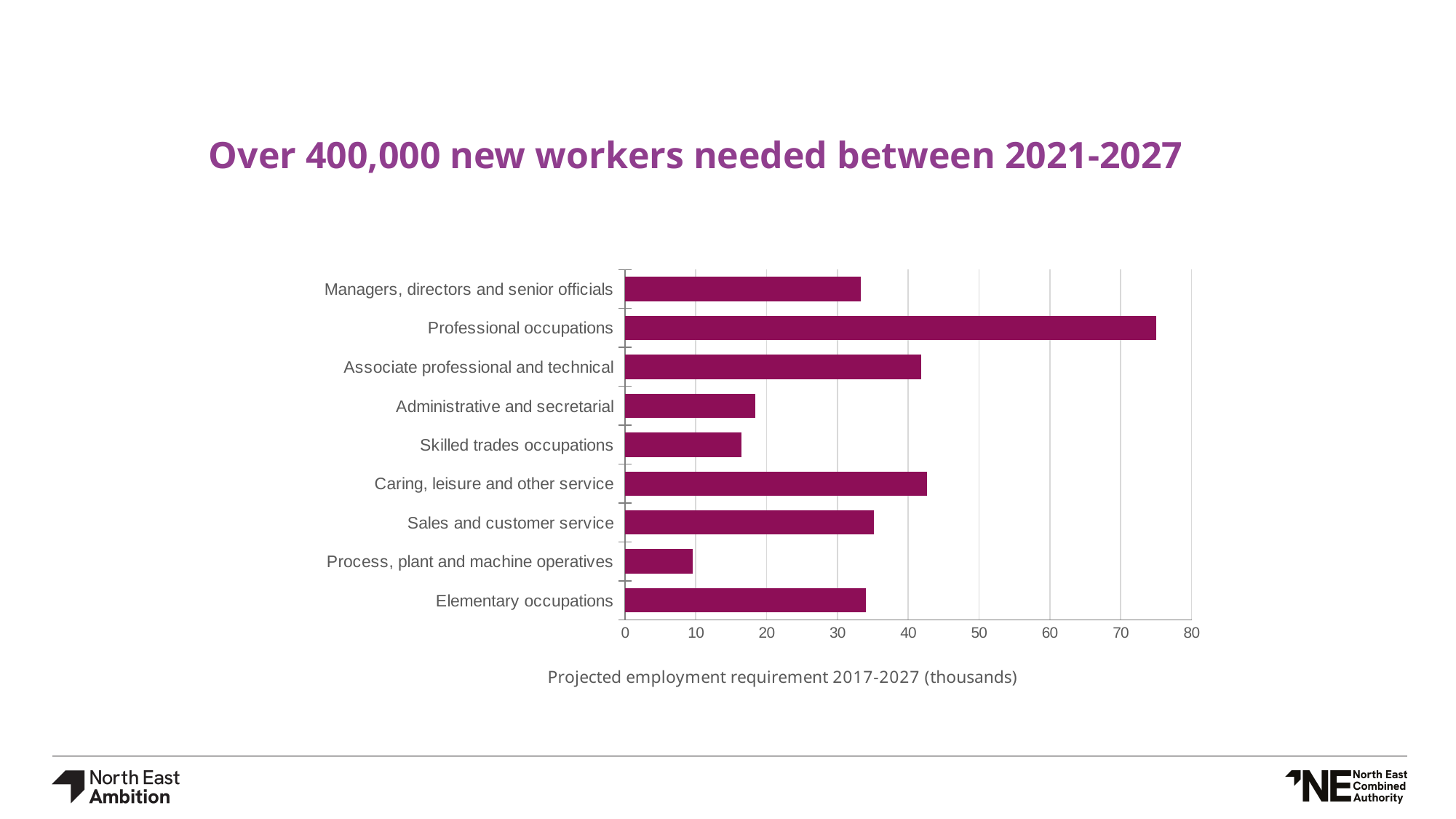
Which is larger, the value for Professional occupations or the value for Managers, directors and senior officials? Professional occupations Is the value for Administrative and secretarial greater or less than 20? less What kind of chart is shown on the slide? bar chart Which is larger, the value for Skilled trades occupations or the value for Caring, leisure and other service? Caring, leisure and other service Is the value for Sales and customer service greater or less than 40? less Which occupation category has the lowest projected employment requirement? Process, plant and machine operatives Which occupation category has the highest projected employment requirement? Professional occupations What is the label on the horizontal axis of the chart? Projected employment requirement 2017-2027 (thousands) Is the value for Caring, leisure and other service greater or less than 40? greater How many occupation categories are plotted in the chart? 9